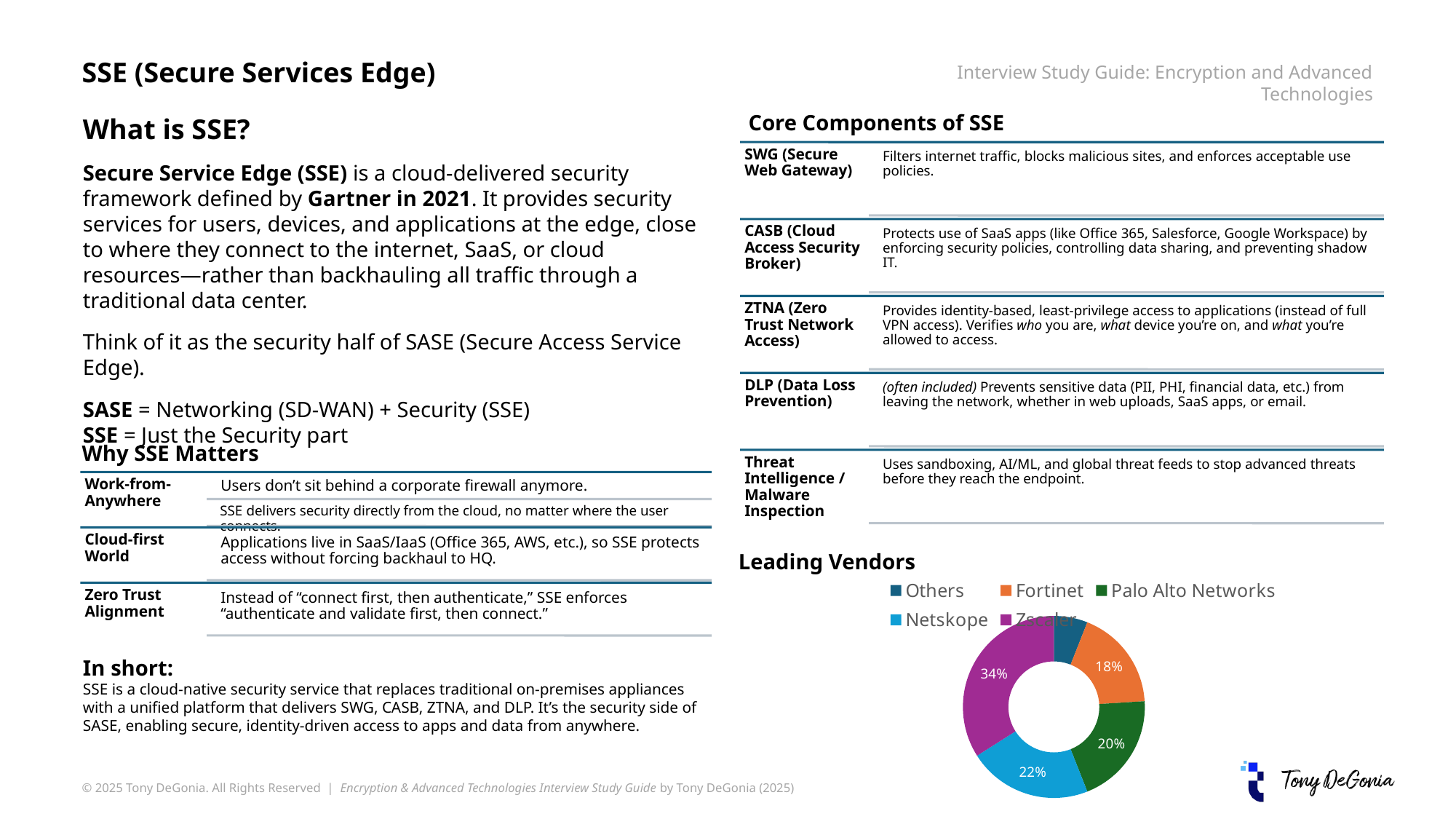
In the Leading Vendors chart, what is the largest share shown as a data label? 34% How many categories does the Leading Vendors chart's legend list? 5 What colour is the Fortinet slice in the Leading Vendors chart? Orange In the Leading Vendors chart, how many percentage points larger is the 34% slice than Palo Alto Networks' slice? 14 In the Leading Vendors chart, what share does Palo Alto Networks have? 20% In the Leading Vendors chart, which vendor has the largest slice? Zscaler In the Leading Vendors chart, which category has the smallest slice? Others In the Leading Vendors chart, what share does Netskope have? 22% In the Leading Vendors chart, how many percentage points larger is Netskope's share than Fortinet's? 4 In the Leading Vendors chart, which has a larger share, Netskope or Palo Alto Networks? Netskope In the Leading Vendors chart, what share does Fortinet have? 18% What type of chart is used for Leading Vendors? Doughnut (pie) chart